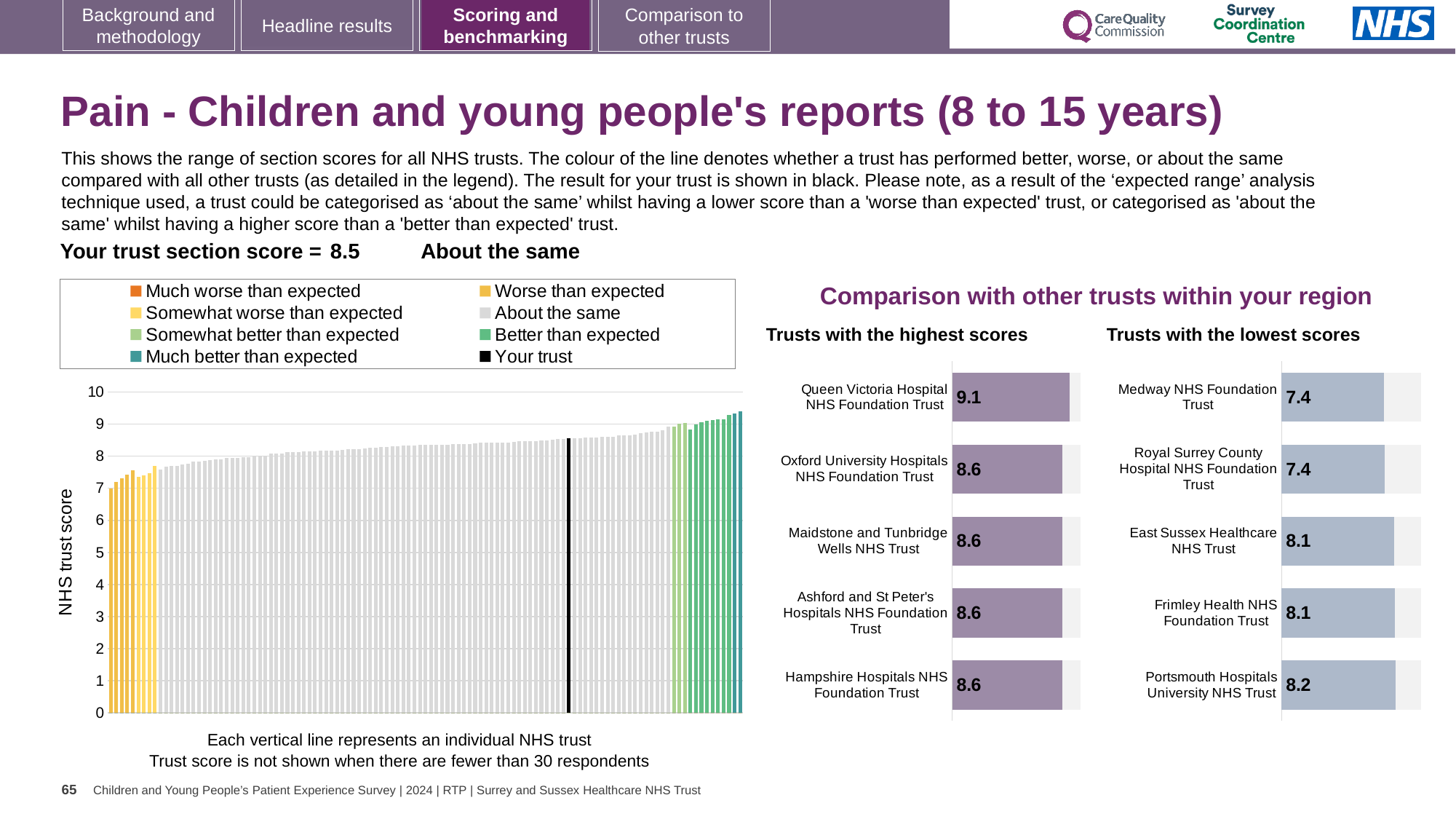
In the 'Trusts with the highest scores' chart, what is the difference between the score for Queen Victoria Hospital NHS Foundation Trust and the score for Oxford University Hospitals NHS Foundation Trust? 0.5 What kind of chart is the large chart on the left with the 'NHS trust score' axis? bar chart In the 'Trusts with the highest scores' chart, which trust has the highest score? Queen Victoria Hospital NHS Foundation Trust In the large chart on the left, is the value of the black bar (Your trust) greater or less than 8? greater In the 'Trusts with the lowest scores' chart, which trust has the highest score shown? Portsmouth Hospitals University NHS Trust Which is larger: the score for East Sussex Healthcare NHS Trust in the 'Trusts with the lowest scores' chart or the score for Hampshire Hospitals NHS Foundation Trust in the 'Trusts with the highest scores' chart? Hampshire Hospitals NHS Foundation Trust In the 'Trusts with the highest scores' chart, what is the score for Queen Victoria Hospital NHS Foundation Trust? 9.1 How many entries does the legend above the large chart on the left list? 8 In the 'Trusts with the lowest scores' chart, what is the difference between the score for Portsmouth Hospitals University NHS Trust and the score for Medway NHS Foundation Trust? 0.8 In the 'Trusts with the lowest scores' chart, what is the score for Portsmouth Hospitals University NHS Trust? 8.2 How many trusts are listed in the 'Trusts with the lowest scores' chart? 5 In the large chart on the left, is the value of the lowest bar greater or less than 8? less